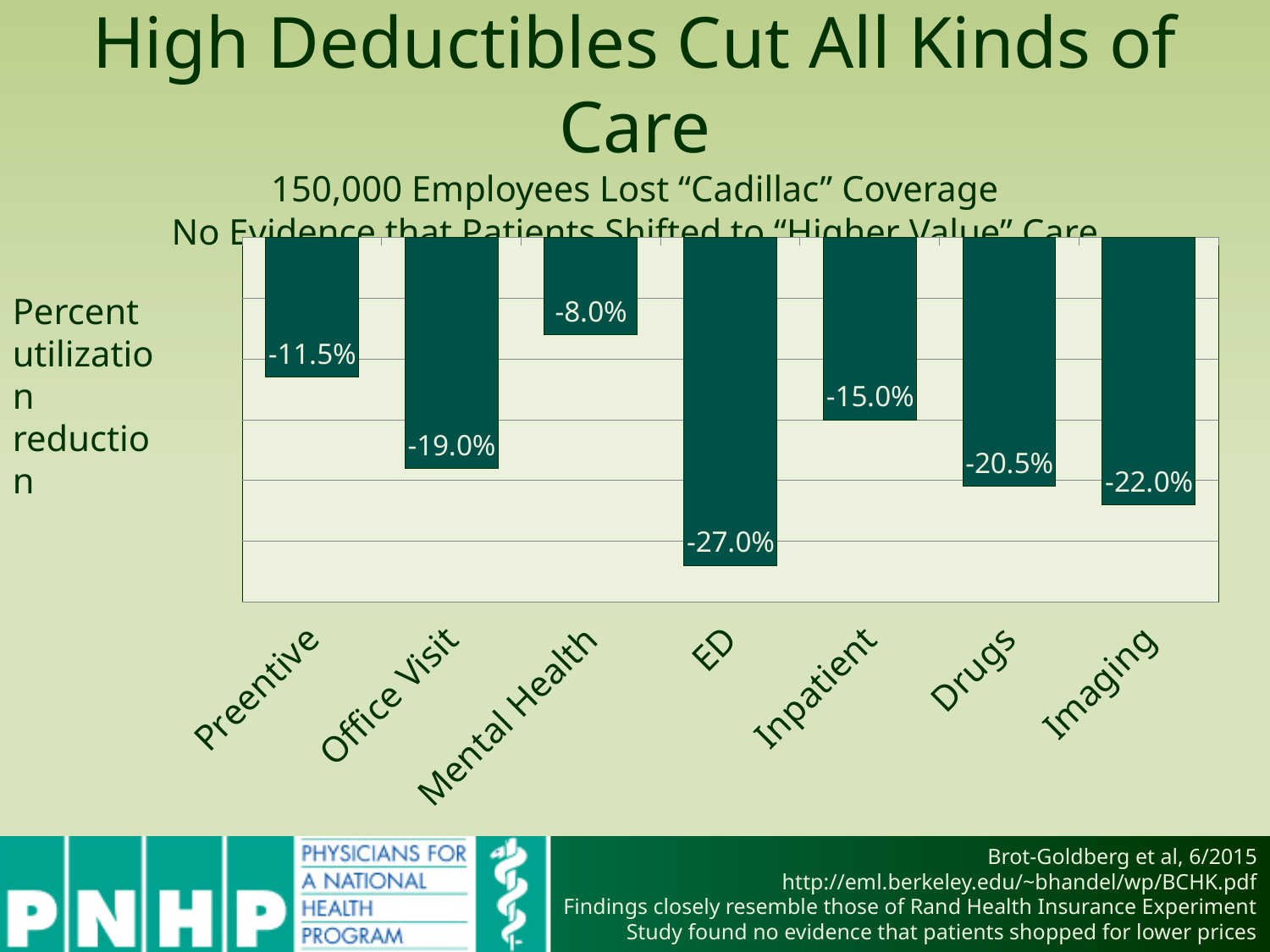
What value is shown for Drugs? -20.5% What kind of chart is shown on the slide? Bar chart What is the percent utilization reduction shown for ED? -27.0% How many percentage points larger is the reduction for ED than for Mental Health? 19.0 What value is shown for Inpatient? -15.0% What does the label to the left of the chart say the bars represent? Percent utilization reduction What value is shown for Office Visit? -19.0% Which category shows the smallest utilization reduction? Mental Health How many categories are plotted in the chart? 7 What value is shown for Imaging? -22.0% Which has a larger utilization reduction, Drugs or Inpatient? Drugs Which category shows the largest utilization reduction? ED